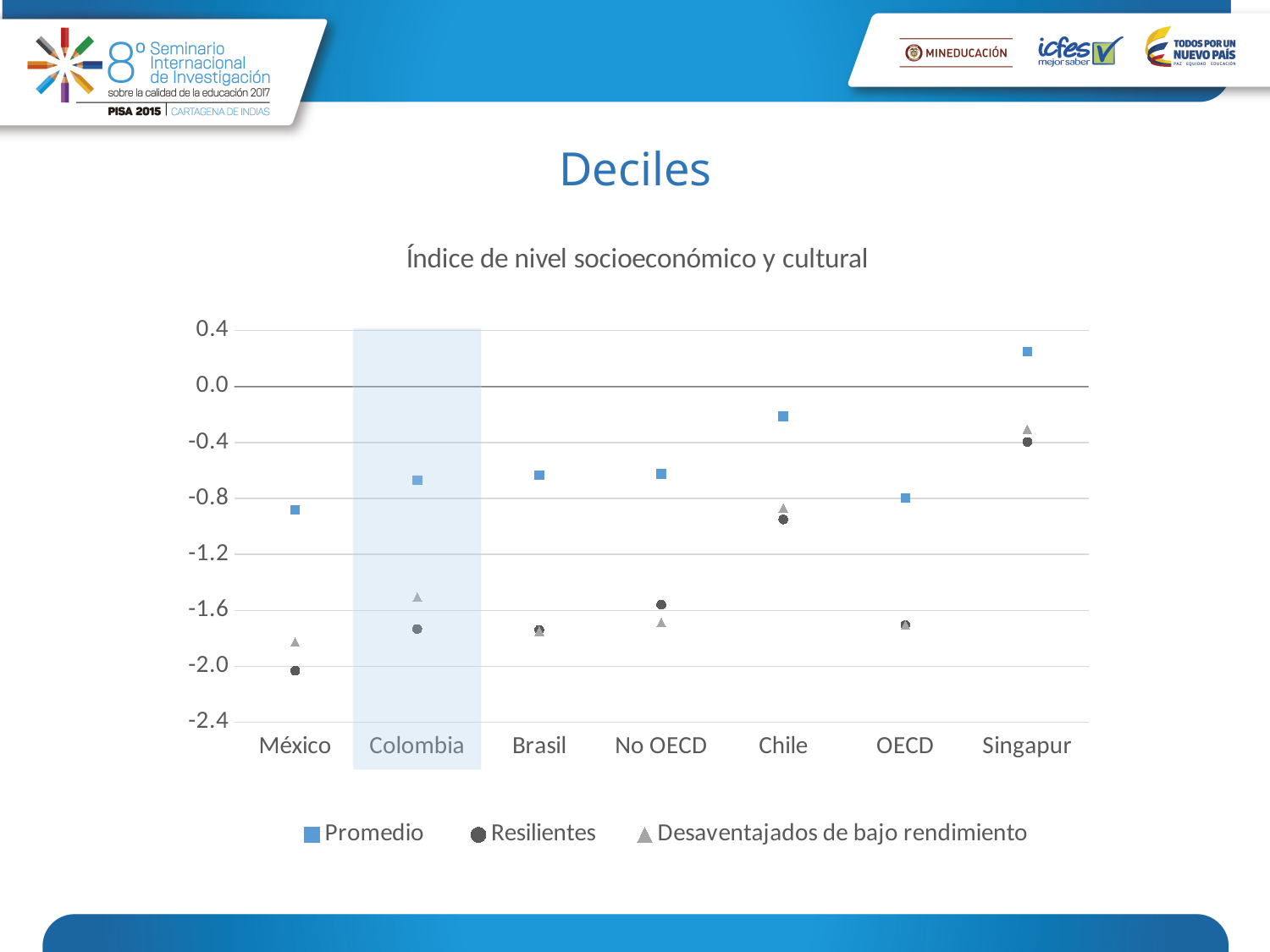
Which category has the lowest Promedio value? México Which category has the lowest Resilientes value? México Which category has the highest Resilientes value? Singapur How many series does the legend list? 3 What is the title of the chart? Índice de nivel socioeconómico y cultural Which category has the highest Promedio value? Singapur Is the Promedio value for Singapur greater or less than 0.0? greater How many categories are shown on the x axis? 7 Is the Promedio value for Chile greater or less than -0.4? greater What kind of chart is shown on the slide? scatter chart Which is larger, the Promedio value for Chile or the Promedio value for OECD? Chile Is the Resilientes value for Colombia greater or less than -1.6? less